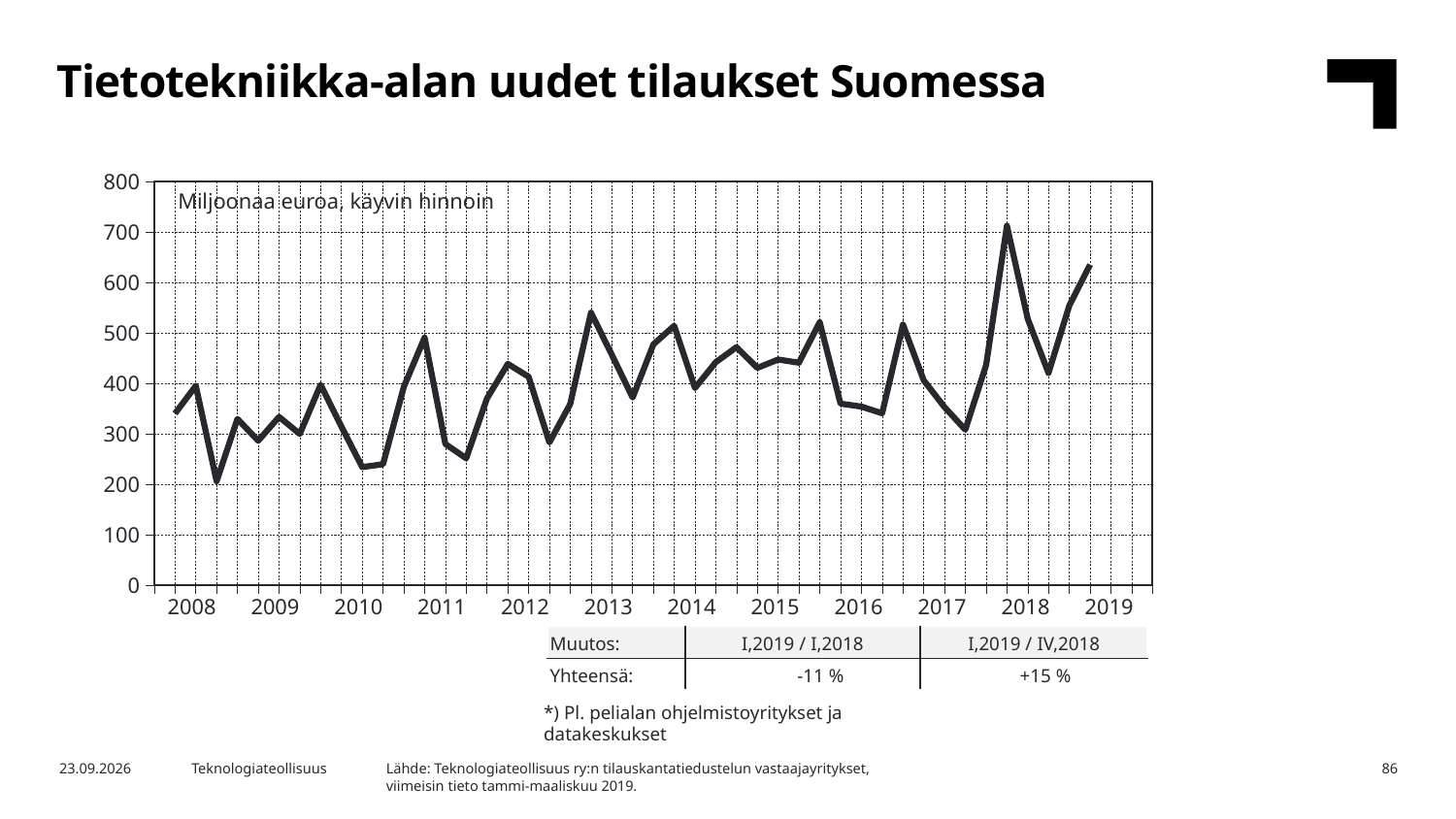
What is the change in total new orders for I,2019 compared with I,2018, as shown in the table below the chart? -11 % What is the title of the chart? Tietotekniikka-alan uudet tilaukset Suomessa What is the change in total new orders for I,2019 compared with IV,2018, as shown in the table below the chart? +15 % Is the lowest point of the line in 2008 greater or less than 300? less In which year does the line reach its highest peak? 2018 In what unit are the values on the chart expressed, according to the label inside the plot area? Miljoonaa euroa, käyvin hinnoin Is the last plotted value in 2019 greater or less than 500? greater How many years are labelled on the x axis? 12 Is the highest peak of the line in 2018 greater or less than 600? greater Is the peak of the line in 2018 higher or lower than the peak in 2013? higher In which year does the line reach its lowest point? 2008 What kind of chart is shown on the slide? line chart